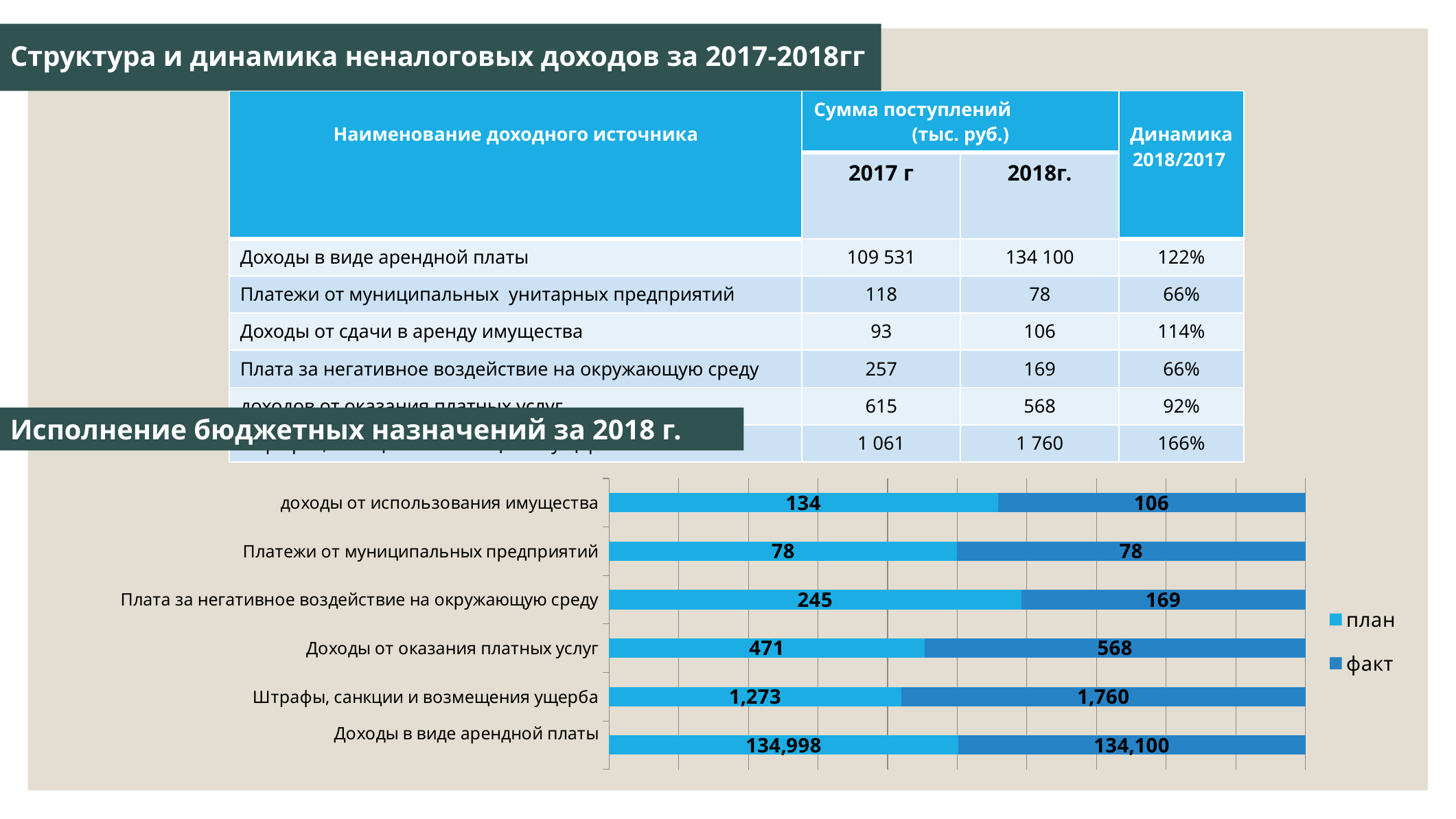
How many categories are shown in the chart? 6 In the chart, what is the план value for Плата за негативное воздействие на окружающую среду? 245 In the chart, for Доходы от оказания платных услуг, which is larger: план or факт? факт In the chart, what is the difference between the факт and план values for Штрафы, санкции и возмещения ущерба? 487 In the chart, which category has the lowest факт value? Платежи от муниципальных предприятий In the chart, what is the факт value for Доходы в виде арендной платы? 134,100 What kind of chart is shown on the slide? Stacked bar chart How many series does the chart legend list? 2 In the chart, what is the факт value for Доходы от оказания платных услуг? 568 In the chart, what is the план value for Штрафы, санкции и возмещения ущерба? 1,273 In the chart, what is the difference between the план and факт values for Плата за негативное воздействие на окружающую среду? 76 In the chart, which category has the highest план value? Доходы в виде арендной платы